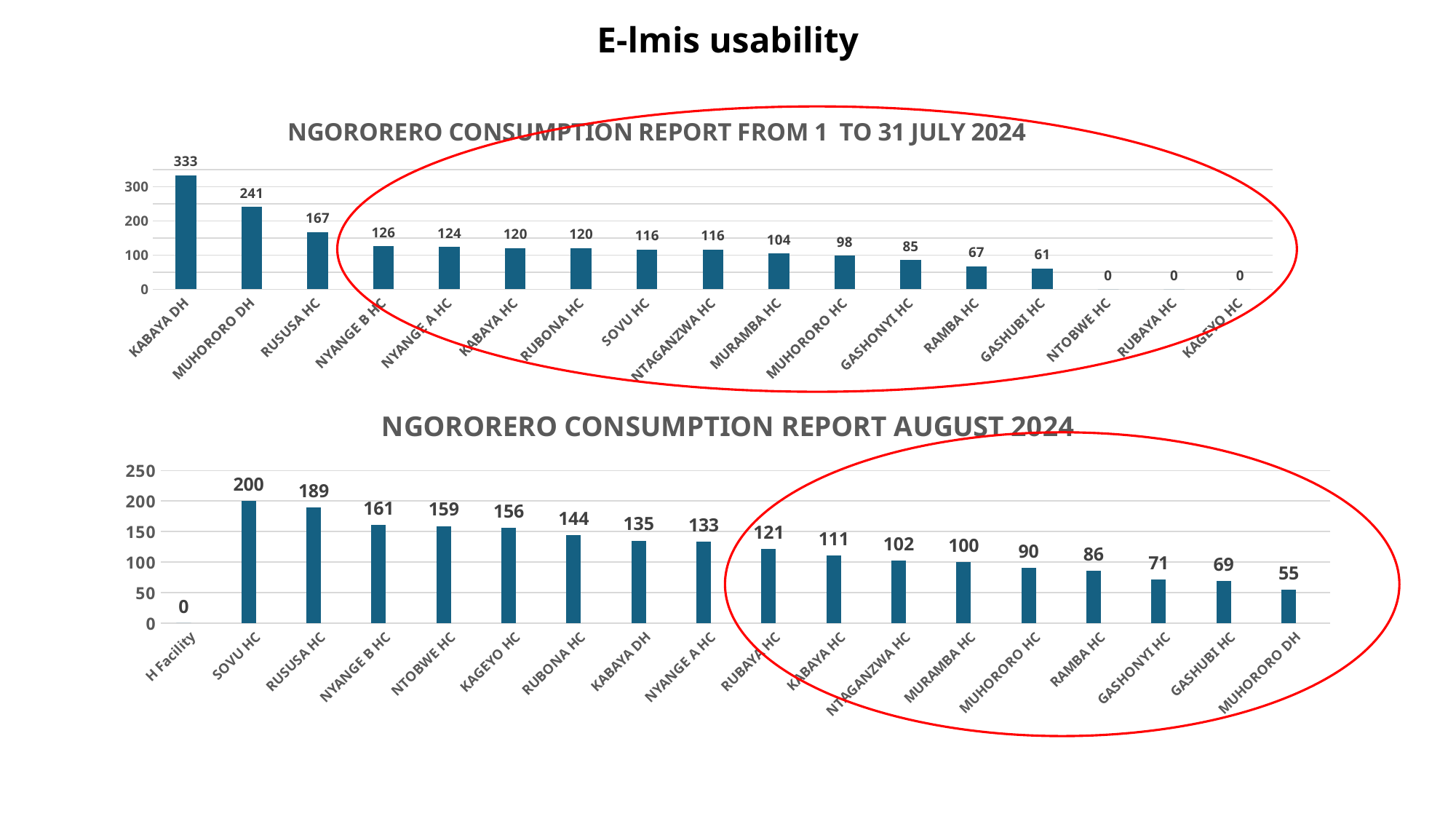
In the August 2024 chart, do the values rise or fall from SOVU HC to MUHORORO DH along the x axis? Fall In the July 2024 chart, how many facilities are shown on the x axis? 17 In the July 2024 chart, what is the value for KABAYA DH? 333 In the August 2024 chart, which facility has the highest value? SOVU HC In the August 2024 chart, which is larger, NTOBWE HC or KAGEYO HC? NTOBWE HC What kind of chart is the August 2024 chart? Bar chart In the August 2024 chart, what is the value for SOVU HC? 200 In the August 2024 chart, what is the value for MUHORORO DH? 55 In the July 2024 chart, what is the value for GASHONYI HC? 85 In the August 2024 chart, what is the difference between RUSUSA HC and NYANGE B HC? 28 In the July 2024 chart, which facility has the highest value? KABAYA DH In the July 2024 chart, what is the difference between MUHORORO DH and RUSUSA HC? 74